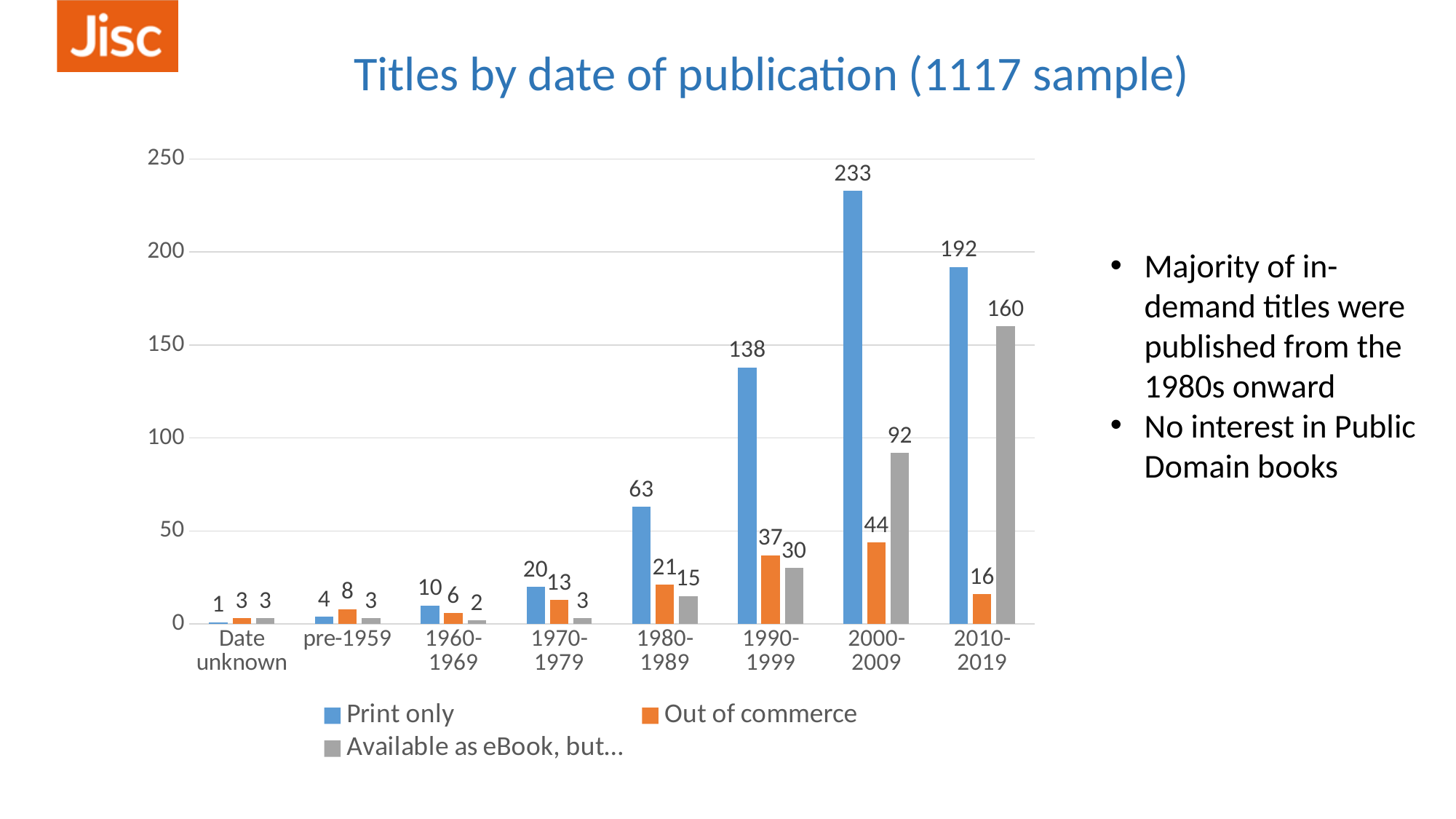
Which date category has the highest Print only value? 2000-2009 How many date categories are shown on the x axis? 8 Which is larger: the Out of commerce value for 2000-2009 or for 2010-2019? 2000-2009 Is the Print only value for 1990-1999 greater or less than 100? greater What is the Out of commerce value for 1990-1999? 37 Which date category has the lowest Print only value? Date unknown What kind of chart is shown on the slide? Bar chart How many series does the legend list? 3 What is the Print only value for 2000-2009? 233 What is the difference between the Print only values for 2000-2009 and 2010-2019? 41 What is the value of the grey 'Available as eBook, but...' series for 2010-2019? 160 What is the title of the chart? Titles by date of publication (1117 sample)